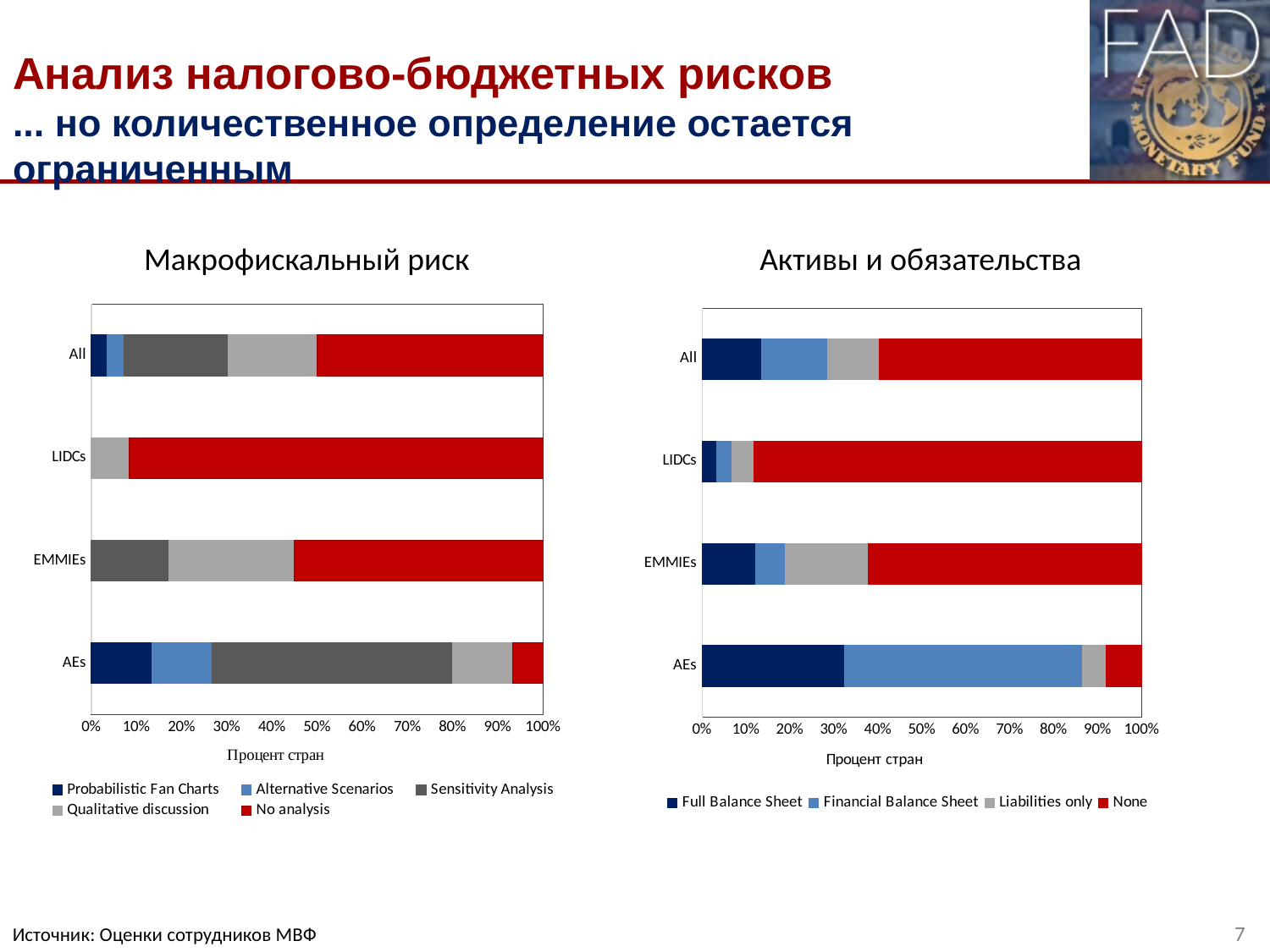
What kind of chart is the 'Макрофискальный риск' chart? Stacked bar chart How many categories are shown on the y axis of the 'Активы и обязательства' chart? 4 In the 'Макрофискальный риск' chart, is the 'No analysis' share larger for LIDCs or for AEs? LIDCs How many series does the legend of the 'Активы и обязательства' chart list? 4 In the 'Макрофискальный риск' chart, is the 'No analysis' share for LIDCs greater or less than 80%? greater In the 'Макрофискальный риск' chart, which category has the largest 'No analysis' share? LIDCs What is the x-axis label of the 'Активы и обязательства' chart? Процент стран In the 'Активы и обязательства' chart, which category has the largest 'Full Balance Sheet' share? AEs How many series does the legend of the 'Макрофискальный риск' chart list? 5 In the 'Активы и обязательства' chart, is the 'Full Balance Sheet' share for AEs greater or less than 20%? greater In the 'Макрофискальный риск' chart, is the 'No analysis' share for AEs greater or less than 10%? less